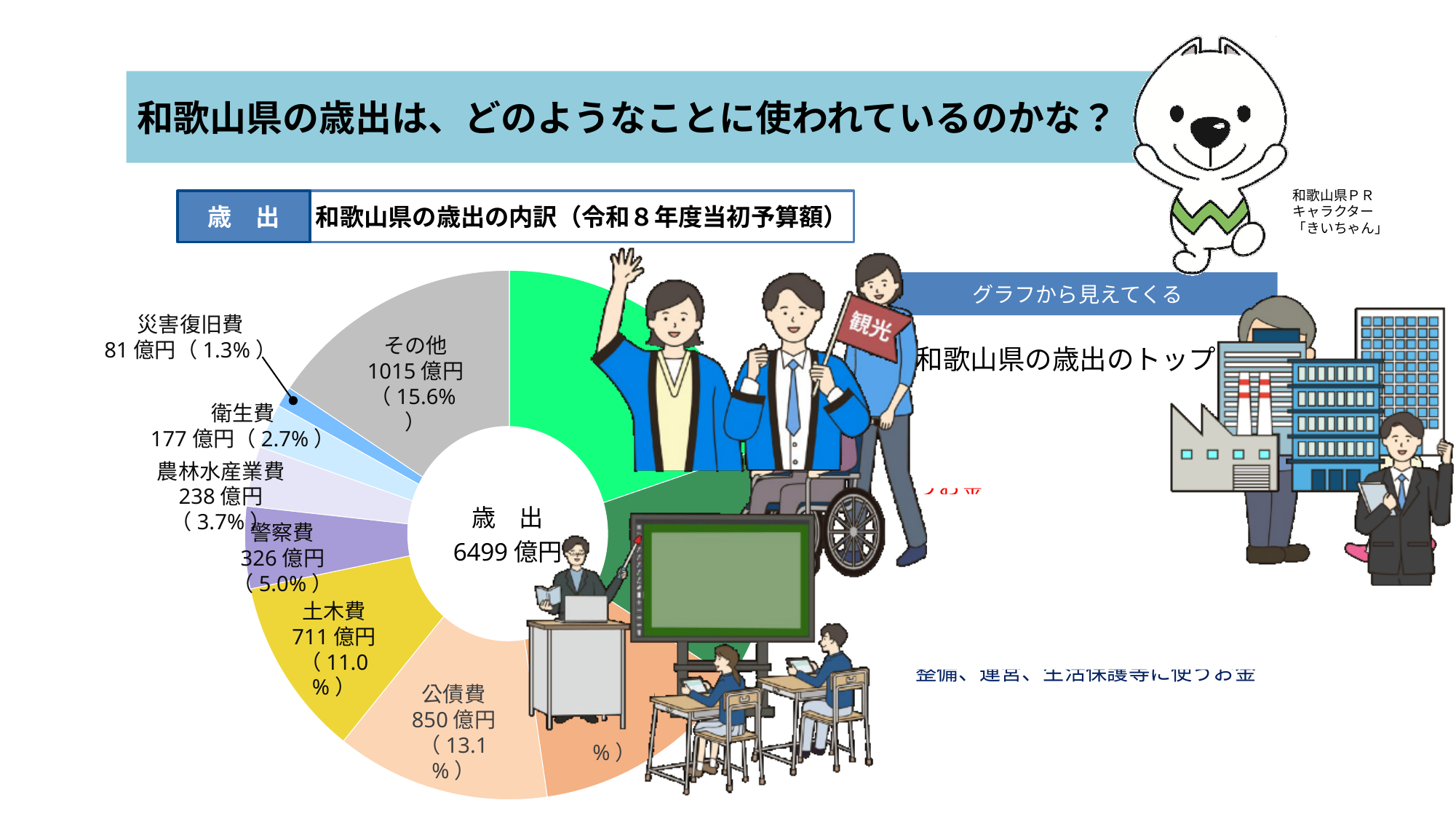
What is the difference between 警察費 and 農林水産業費 in the pie chart? 88 億円 What is the value shown for 公債費 in the pie chart? 850 億円 What is the value shown for 土木費 in the pie chart? 711 億円 Which is larger in the pie chart, 土木費 or 公債費? 公債費 What percentage share does 農林水産業費 have in the pie chart? 3.7% What is the difference between 公債費 and 土木費 in the pie chart? 139 億円 What is the value shown for 警察費 in the pie chart? 326 億円 What total expenditure (歳出) is shown in the centre of the pie chart? 6499 億円 What kind of chart is shown on the slide? pie chart What percentage share does その他 have in the pie chart? 15.6% What is the value shown for 衛生費 in the pie chart? 177 億円 What is the value shown for 災害復旧費 in the pie chart? 81 億円